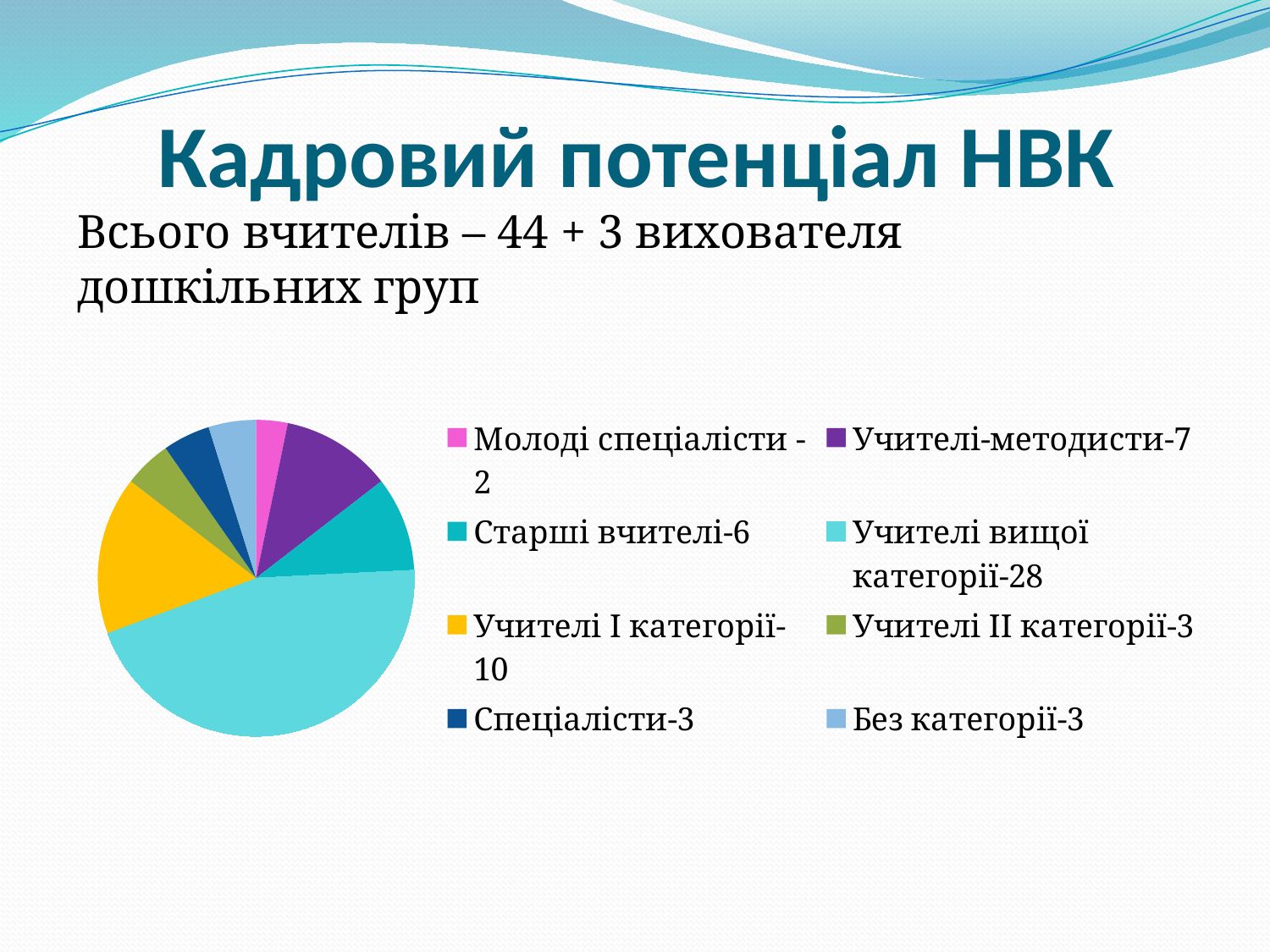
What is the value for Учителі вищої категорії? 28 What is the title of the slide containing the chart? Кадровий потенціал НВК Which is larger: Учителі-методисти or Старші вчителі? Учителі-методисти What is the value for Учителі-методисти? 7 How many categories does the pie chart have? 8 What is the value for Старші вчителі? 6 What colour is the slice for Учителі І категорії? yellow What is the value for Учителі І категорії? 10 Which category has the smallest slice of the pie? Молоді спеціалісти Which category has the largest slice of the pie? Учителі вищої категорії What kind of chart is shown on the slide? pie chart What is the difference between Учителі вищої категорії and Учителі І категорії? 18